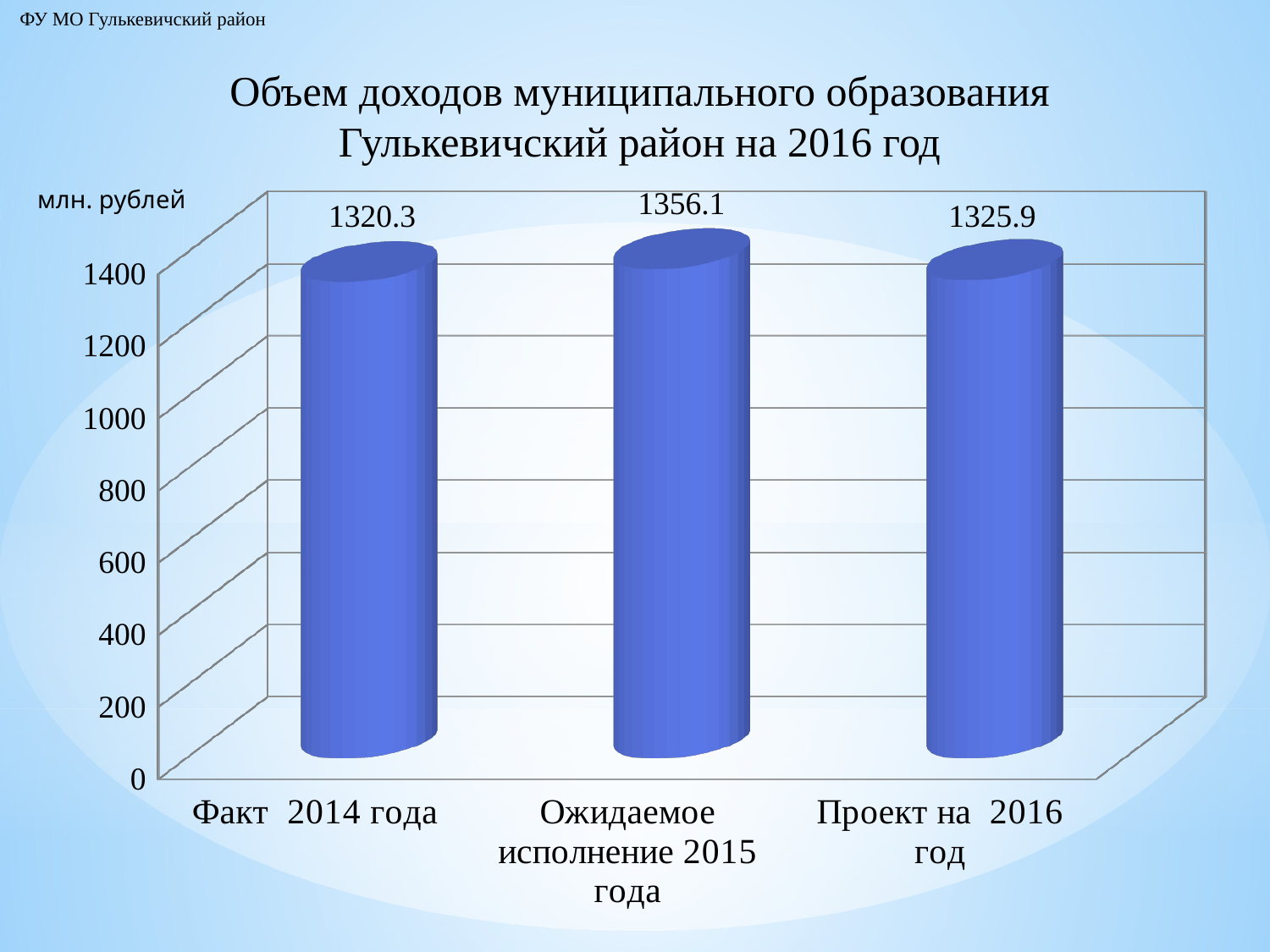
Is the value for Проект на 2016 год greater or less than 1200? greater What is the value for Ожидаемое исполнение 2015 года? 1356.1 What is the difference between the values for Ожидаемое исполнение 2015 года and Факт 2014 года? 35.8 What is the value for Проект на 2016 год? 1325.9 Which is larger, the value for Проект на 2016 год or the value for Факт 2014 года? Проект на 2016 год What is the value for Факт 2014 года? 1320.3 What unit is shown for the values on the chart? млн. рублей Which category has the lowest value? Факт 2014 года How many categories are shown on the chart? 3 What kind of chart is shown on the slide? bar chart Which category has the highest value? Ожидаемое исполнение 2015 года What is the difference between the values for Ожидаемое исполнение 2015 года and Проект на 2016 год? 30.2